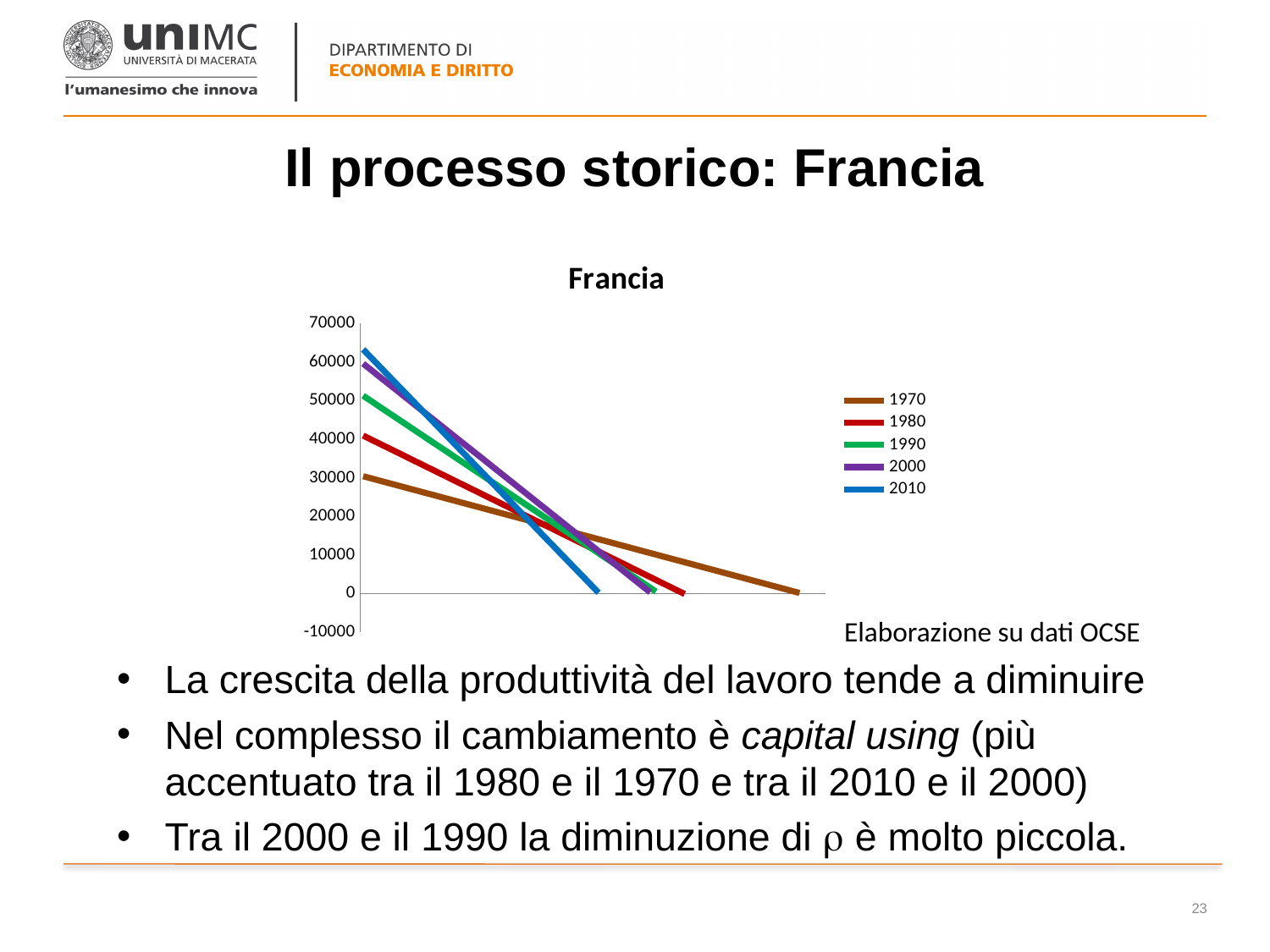
What is the title of the chart? Francia Which series' line reaches zero furthest to the right on the chart? 1970 Which line starts higher on the left, 1980 or 1990? 1990 Do the lines in the chart rise or fall from left to right? fall How many series does the legend of the chart list? 5 Which series are listed in the chart's legend? 1970, 1980, 1990, 2000, 2010 Which series starts at the highest value on the left side of the chart? 2010 Is the starting value of the 2010 line greater or less than 50000? greater What kind of chart is shown on the slide? line chart Is the starting value of the 1970 line greater or less than 40000? less Is the starting value of the 2000 line greater or less than 50000? greater Which series starts at the lowest value on the left side of the chart? 1970